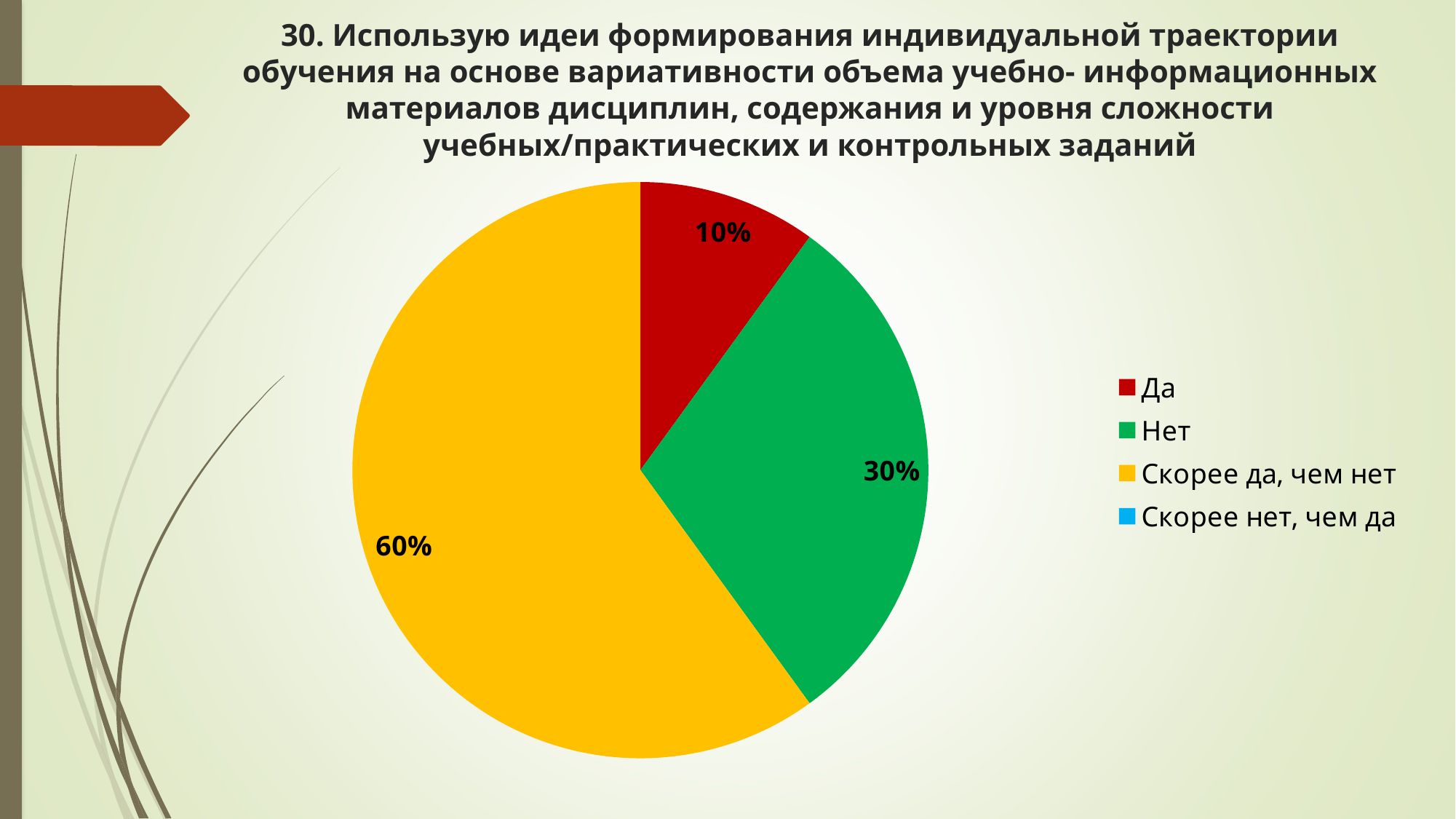
Which category has the largest slice of the pie? Скорее да, чем нет What share of the pie does "Да" have? 10% What share of the pie does "Скорее да, чем нет" have? 60% Which legend entry has no visible slice in the pie? Скорее нет, чем да What share of the pie does "Нет" have? 30% What is the difference between the shares for "Скорее да, чем нет" and "Нет"? 30% What is the difference between the shares for "Нет" and "Да"? 20% What colour is the slice for "Скорее да, чем нет"? yellow Which labelled slice is the smallest? Да Which is larger, the share for "Нет" or the share for "Да"? Нет How many entries does the legend list? 4 What kind of chart is shown on the slide? pie chart